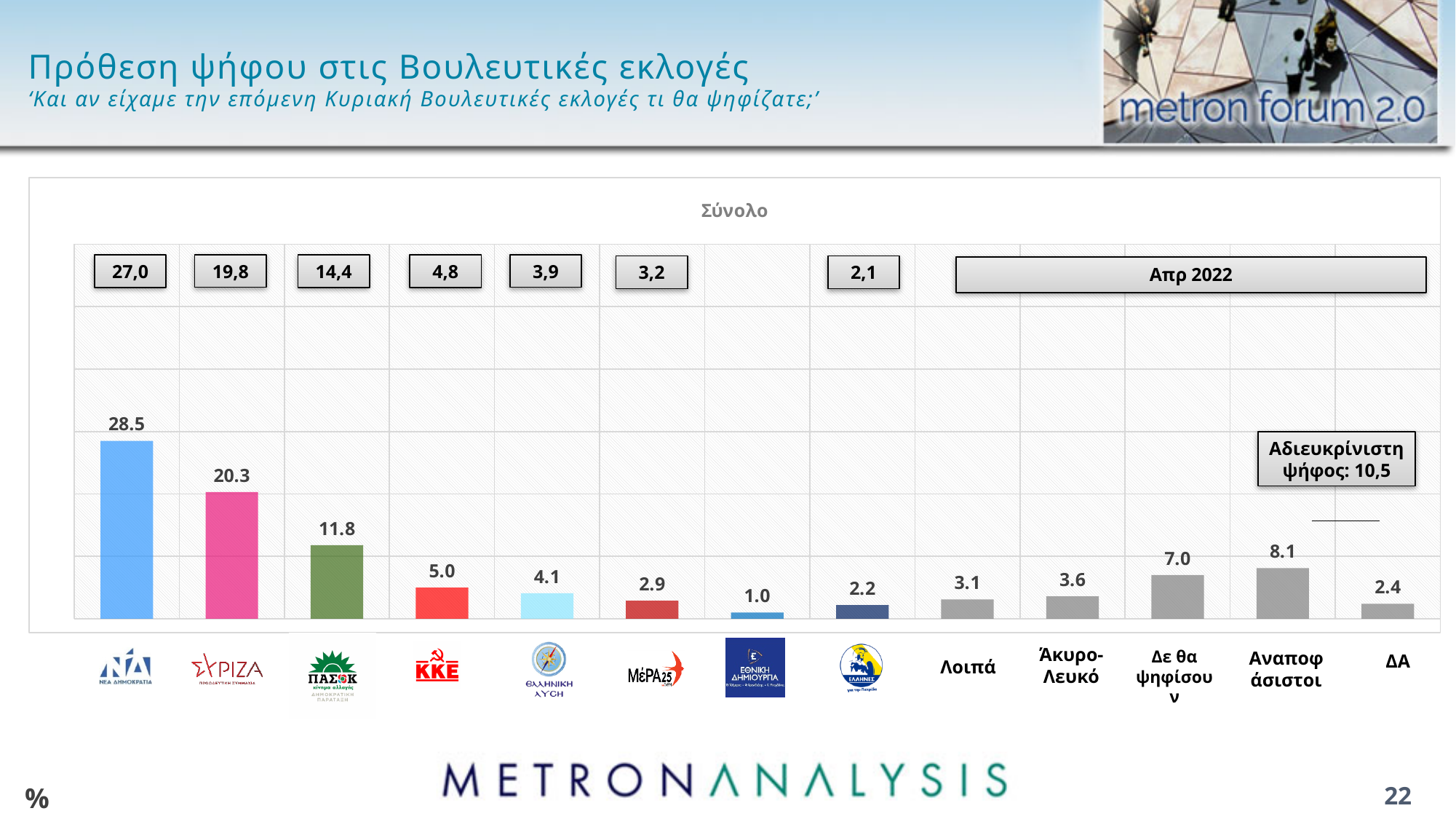
What is the value of the bar for Αναποφάσιστοι? 8.1 What is the value of the bar for ΚΚΕ? 5.0 Which category has the highest bar? ΝΕΑ ΔΗΜΟΚΡΑΤΙΑ What kind of chart is shown on the slide? Bar chart Which category has the lowest bar? ΕΘΝΙΚΗ ΔΗΜΙΟΥΡΓΙΑ (1.0) What is the difference between the bars for ΝΕΑ ΔΗΜΟΚΡΑΤΙΑ and ΣΥΡΙΖΑ? 8.2 What is the value of the bar for Λοιπά? 3.1 What is the value of the bar for ΔΑ? 2.4 What is the Απρ 2022 value shown in the box above the ΠΑΣΟΚ bar? 14,4 Which is larger, the bar for Δε θα ψηφίσουν or the bar for Άκυρο-Λευκό? Δε θα ψηφίσουν How many bars are plotted in the chart? 13 What is the title shown above the chart? Σύνολο